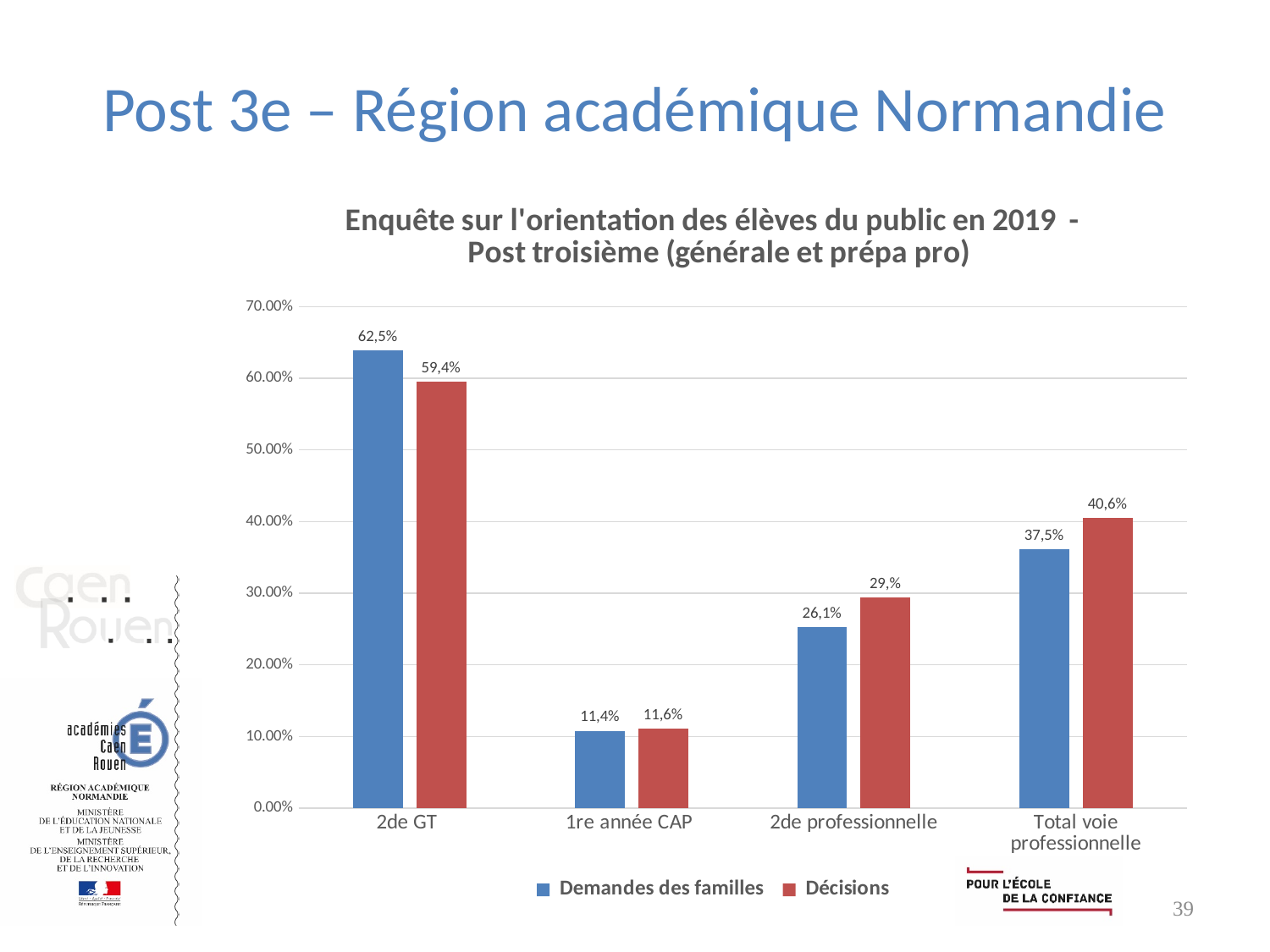
What is the value of Demandes des familles for 1re année CAP? 11,4% How many series does the legend list? 2 What is the difference between Demandes des familles and Décisions for 2de GT? 3,1% For Total voie professionnelle, which is larger: Demandes des familles or Décisions? Décisions What is the value of Décisions for 2de GT? 59,4% Which category has the lowest value for Décisions? 1re année CAP How many categories are shown on the x axis? 4 Which series is shown in blue? Demandes des familles Which category has the highest value for Demandes des familles? 2de GT What is the value of Demandes des familles for 2de GT? 62,5% What kind of chart is shown on the slide? bar chart What is the value of Décisions for Total voie professionnelle? 40,6%